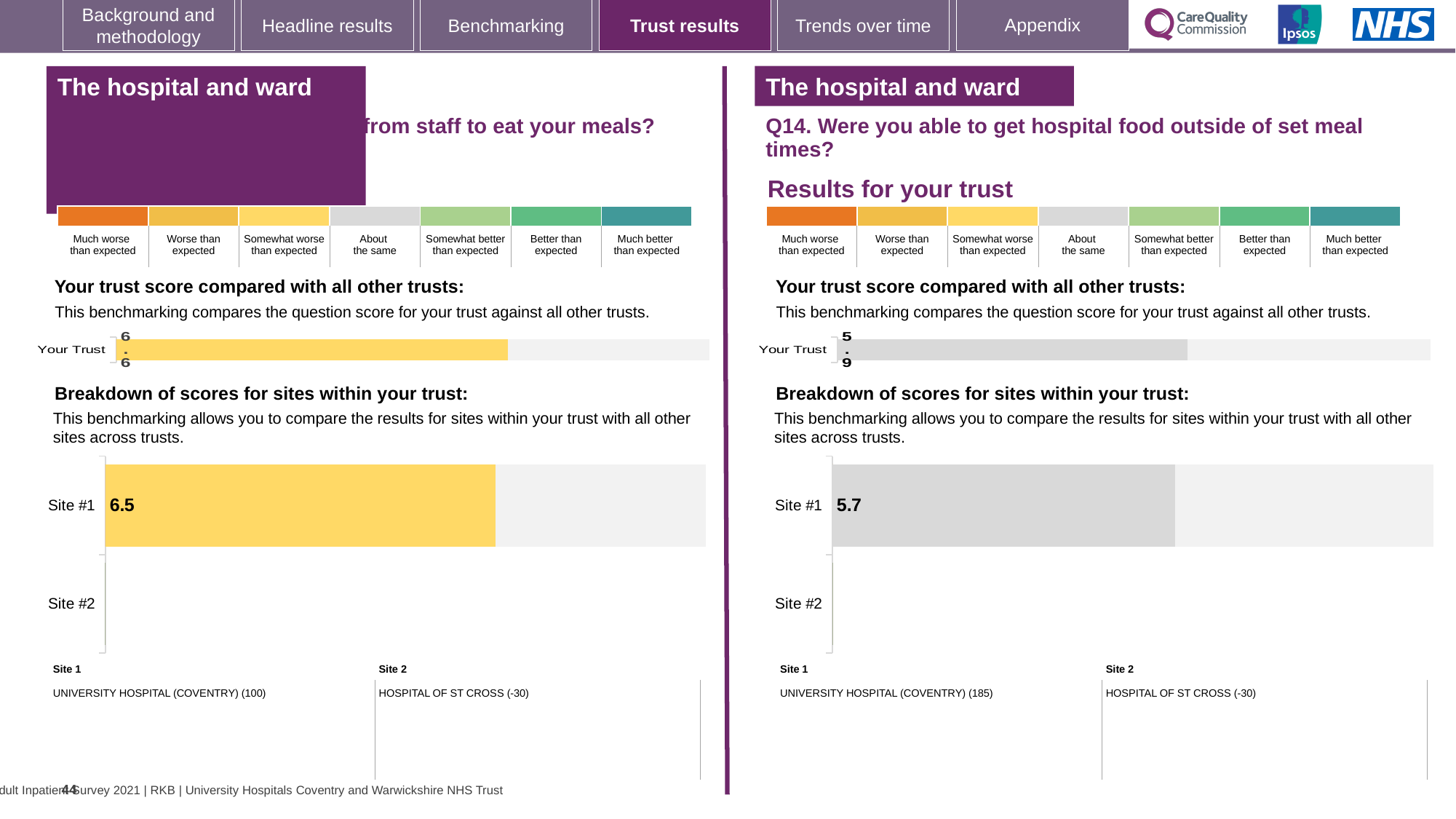
In the right (Q14) breakdown chart, which site has a bar plotted? Site #1 In the left 'Breakdown of scores for sites within your trust' chart, what is the score for Site #1? 6.5 On the left half of the slide, what is the difference between the 'Your Trust' score and the Site #1 score? 0.1 What colour is the Site #1 bar in the left breakdown chart? Yellow Which is larger: the Site #1 score in the left breakdown chart or the Site #1 score in the right (Q14) breakdown chart? Left chart (6.5) On the right half of the slide (Q14), what is the difference between the 'Your Trust' score and the Site #1 score? 0.2 What type of chart is used to show the 'Your Trust' score on each half of the slide? Bar chart On the left half of the slide, what is the 'Your Trust' score shown in the trust score bar chart? 6.6 What is the difference between the Site #1 score in the left breakdown chart and the Site #1 score in the right (Q14) breakdown chart? 0.8 In the right 'Breakdown of scores for sites within your trust' chart (Q14), what is the score for Site #1? 5.7 On the right half of the slide (Q14), what is the 'Your Trust' score shown in the trust score bar chart? 5.9 How many sites are listed in the left 'Breakdown of scores for sites within your trust' chart? 2